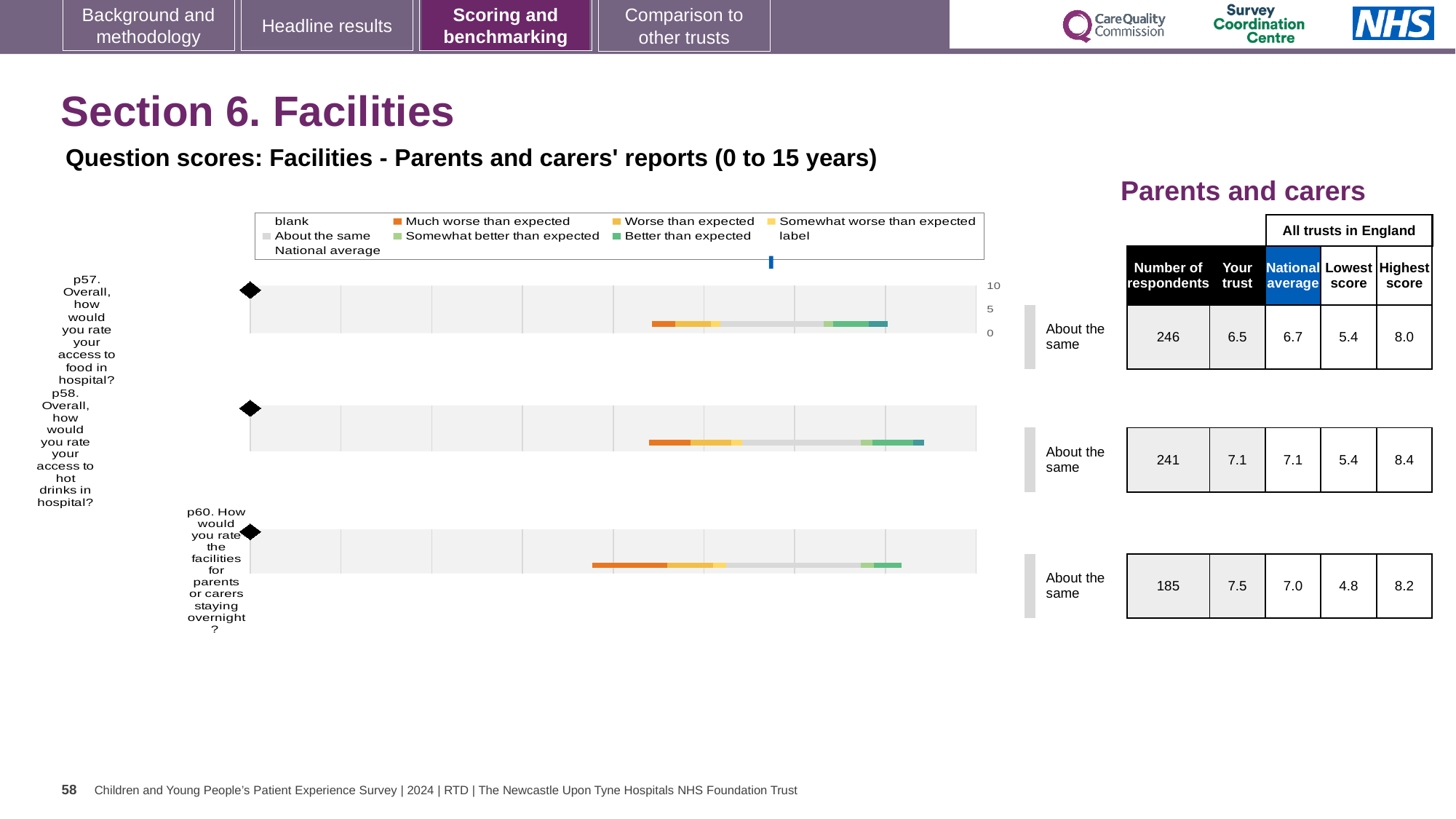
Is the 'Your trust' score for p60 larger or smaller than its national average? larger What kind of chart is used to show the benchmark ranges for each question? bar chart What is the 'Your trust' score for p57, access to food in hospital? 6.5 How many respondents answered p60, facilities for parents or carers staying overnight? 185 What is the 'Your trust' score for p60, facilities for parents or carers staying overnight? 7.5 What benchmark category is shown next to the chart for p57 (access to food in hospital)? About the same What is the difference between the highest score and the lowest score across all trusts for p57? 2.6 Which legend entry is shown in orange? Much worse than expected Which question has the highest 'Your trust' score: p57, p58 or p60? p60 How many survey questions are plotted on the slide's charts? 3 What is the national average for p58, access to hot drinks in hospital? 7.1 What is the highest tick value shown on the vertical axis of the first chart? 10